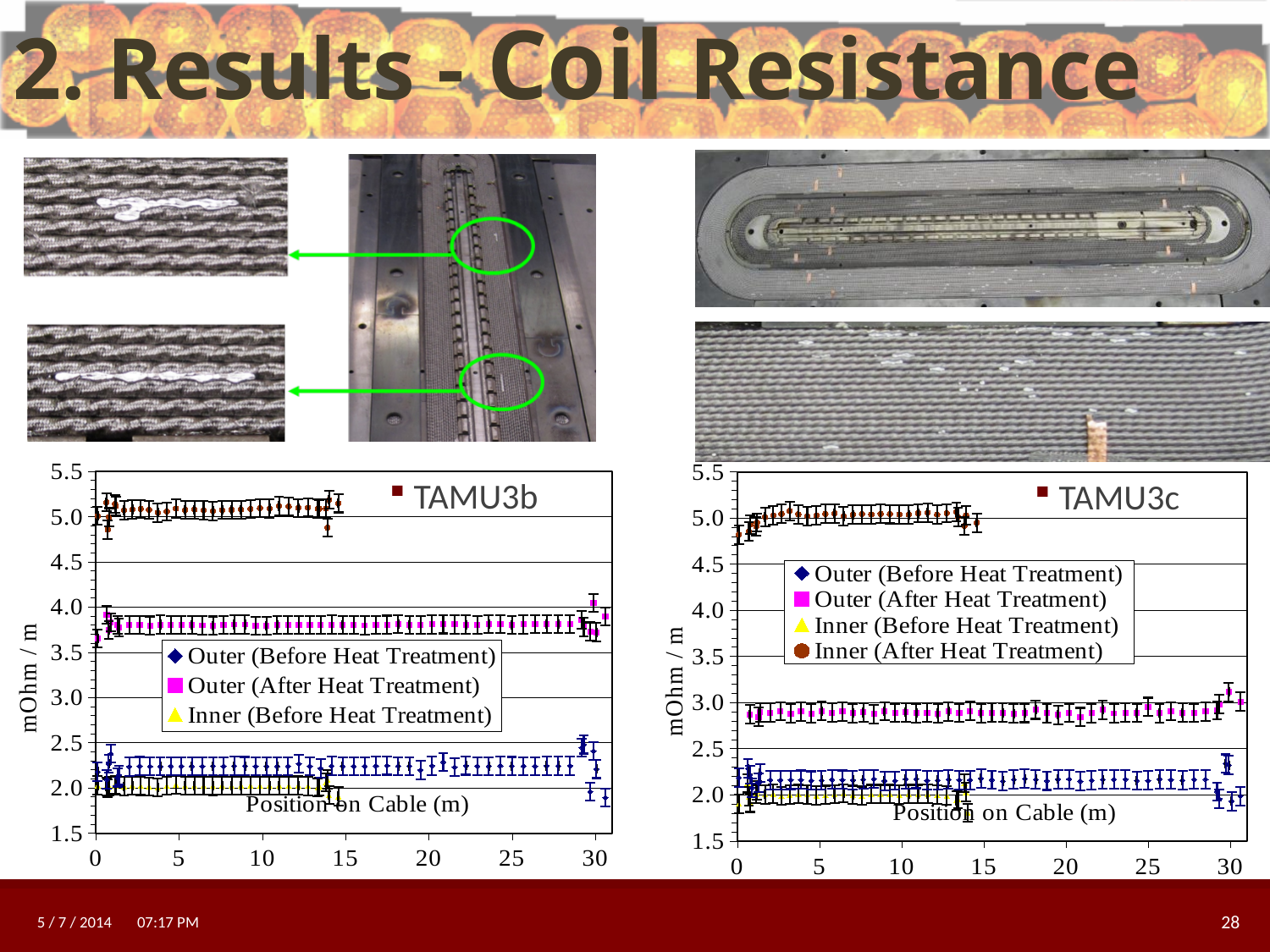
In the TAMU3c chart on the right, are the values of the Outer (Before Heat Treatment) series greater or less than 2.5? less Which chart shows higher values for the Outer (After Heat Treatment) series, TAMU3b or TAMU3c? TAMU3b In the TAMU3c chart on the right, are the values of the Inner (After Heat Treatment) series greater or less than 4.5? greater What is the y-axis label of the TAMU3b chart on the left? mOhm / m In the TAMU3b chart on the left, which series has the highest values: Outer (Before Heat Treatment), Outer (After Heat Treatment), or Inner (Before Heat Treatment)? Outer (After Heat Treatment) In the TAMU3c chart on the right, how many series does the legend box list? 4 What kind of chart is the TAMU3b chart on the left? scatter chart In the TAMU3b chart on the left, are the values of the Outer (After Heat Treatment) series greater or less than 3.5? greater What is the x-axis label of the TAMU3c chart on the right? Position on Cable (m) In the TAMU3c chart on the right, which series has higher values: Outer (After Heat Treatment) or Inner (After Heat Treatment)? Inner (After Heat Treatment) In the TAMU3c chart on the right, does the Inner (After Heat Treatment) series rise, fall, or stay roughly flat along the cable position? roughly flat